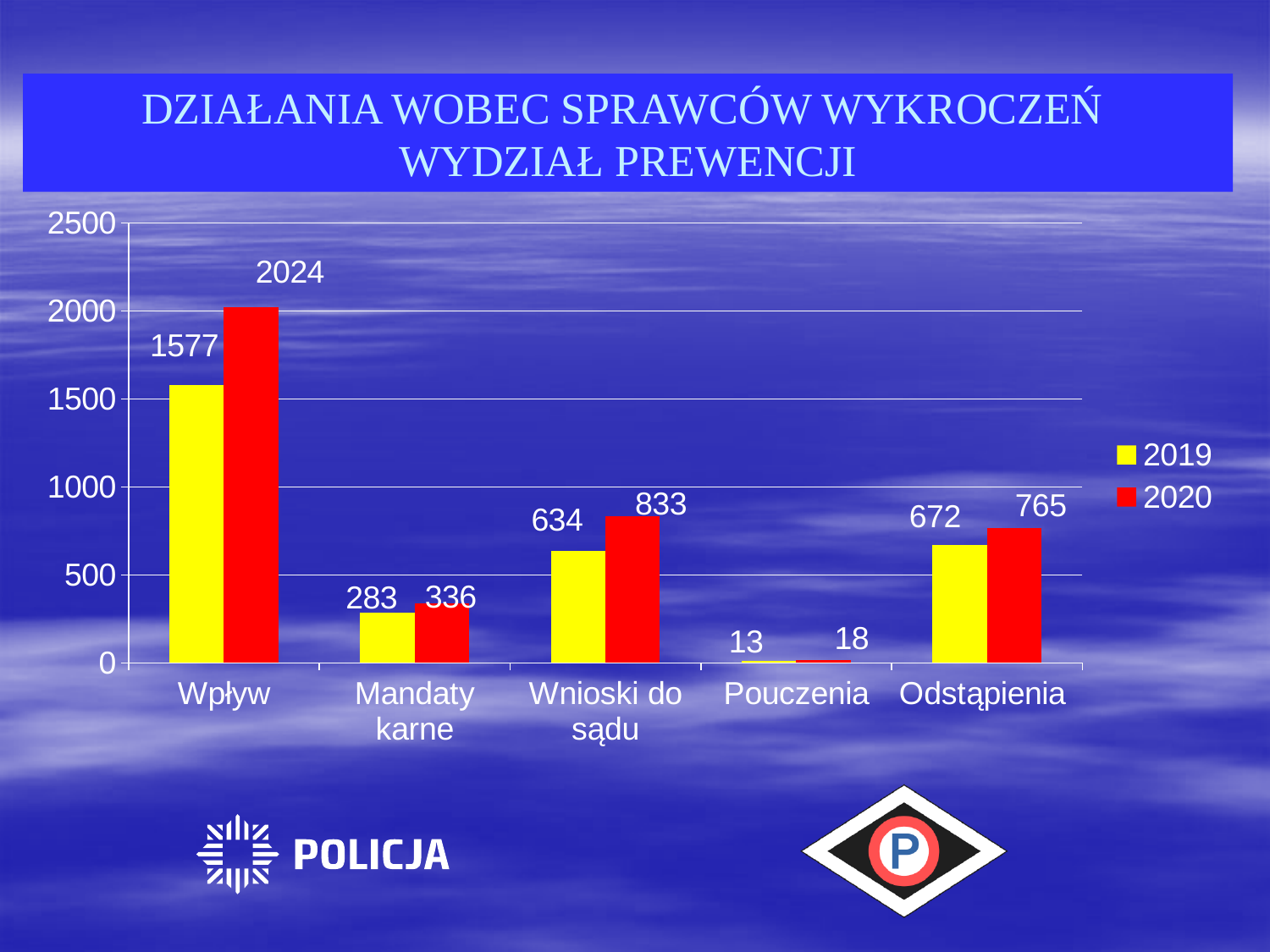
What is the value for Wpływ in 2020? 2024 Which category has the highest value in 2019? Wpływ What is the difference between the 2020 and 2019 values for Wnioski do sądu? 199 What kind of chart is shown on the slide? Bar chart Which is larger: the 2019 value for Odstąpienia or the 2019 value for Wnioski do sądu? Odstąpienia How many series does the legend list? 2 Which category has the lowest value in 2020? Pouczenia What is the value for Odstąpienia in 2019? 672 Which colour represents the 2020 series in the legend? Red What is the value for Mandaty karne in 2019? 283 What is the value for Pouczenia in 2020? 18 How many categories are shown on the x axis? 5